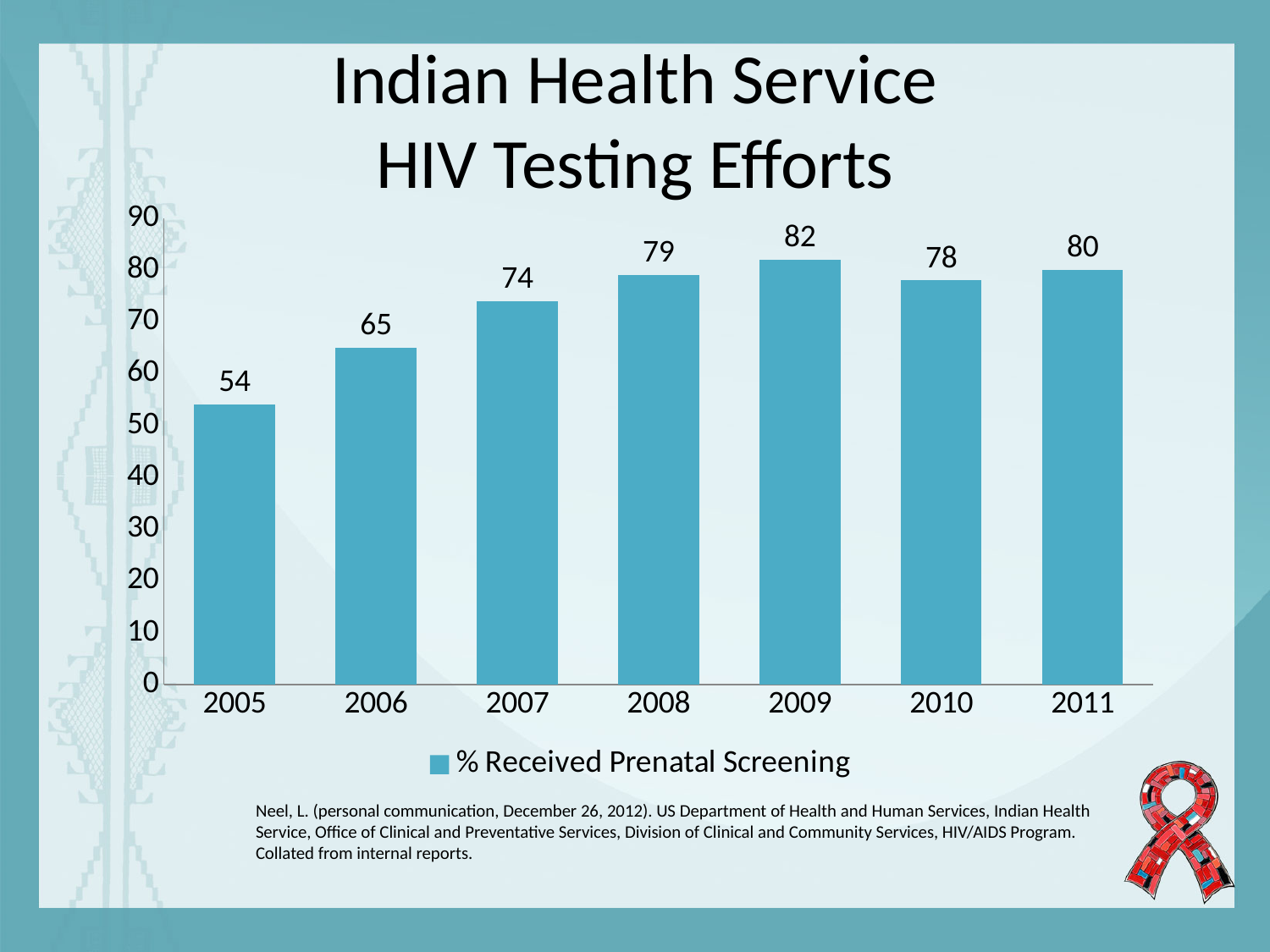
Is the value for 2007 greater or less than 70? greater What is the difference between the values for 2006 and 2005? 11 What is the difference between the values for 2009 and 2010? 4 What kind of chart is shown? bar chart What is the value for 2011? 80 Which is larger, the value for 2008 or the value for 2010? 2008 What is the value for 2009? 82 Which year has the lowest value? 2005 What series does the legend list? % Received Prenatal Screening Which year has the highest value? 2009 How many years are shown on the x axis? 7 What is the value for 2005? 54